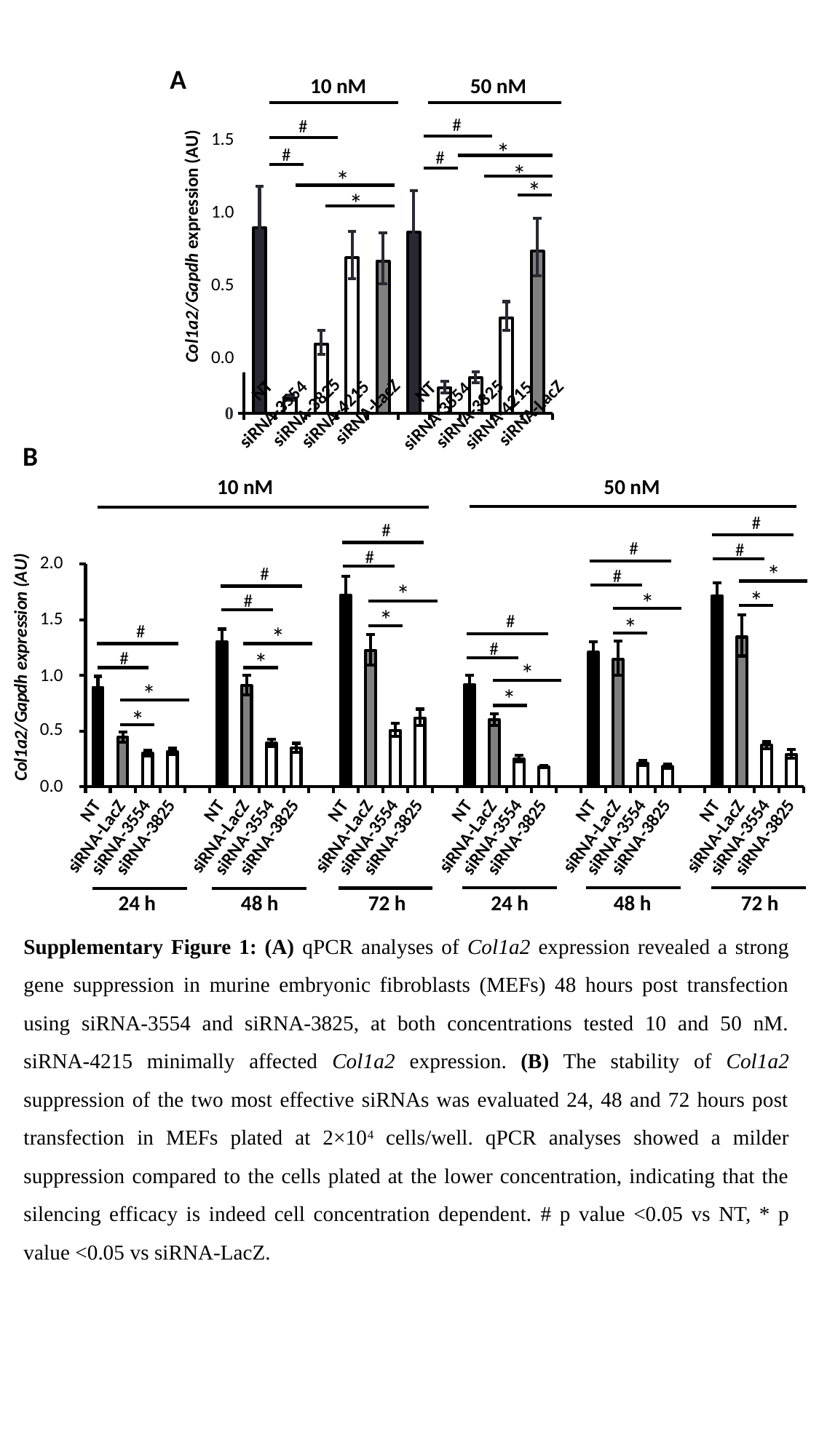
What kind of chart is chart B? bar chart In chart A, which is larger at 10 nM: siRNA-4215 or siRNA-3825? siRNA-4215 In chart B, is the value for NT at 72 h, 10 nM greater or less than 1.5? greater In chart B, what is the y-axis label? Col1a2/Gapdh expression (AU) In chart B, how many time points are shown for each concentration? 3 In chart B, is the value for siRNA-LacZ at 72 h, 50 nM greater or less than 1.0? greater In chart A, is the value for NT at 10 nM greater or less than 0.5? greater In chart B, which bar is highest in the 48 h, 10 nM group? NT In chart B, which is larger at 24 h, 10 nM: NT or siRNA-LacZ? NT In chart B, how many bars are in each time-point group (e.g. 24 h at 10 nM)? 4